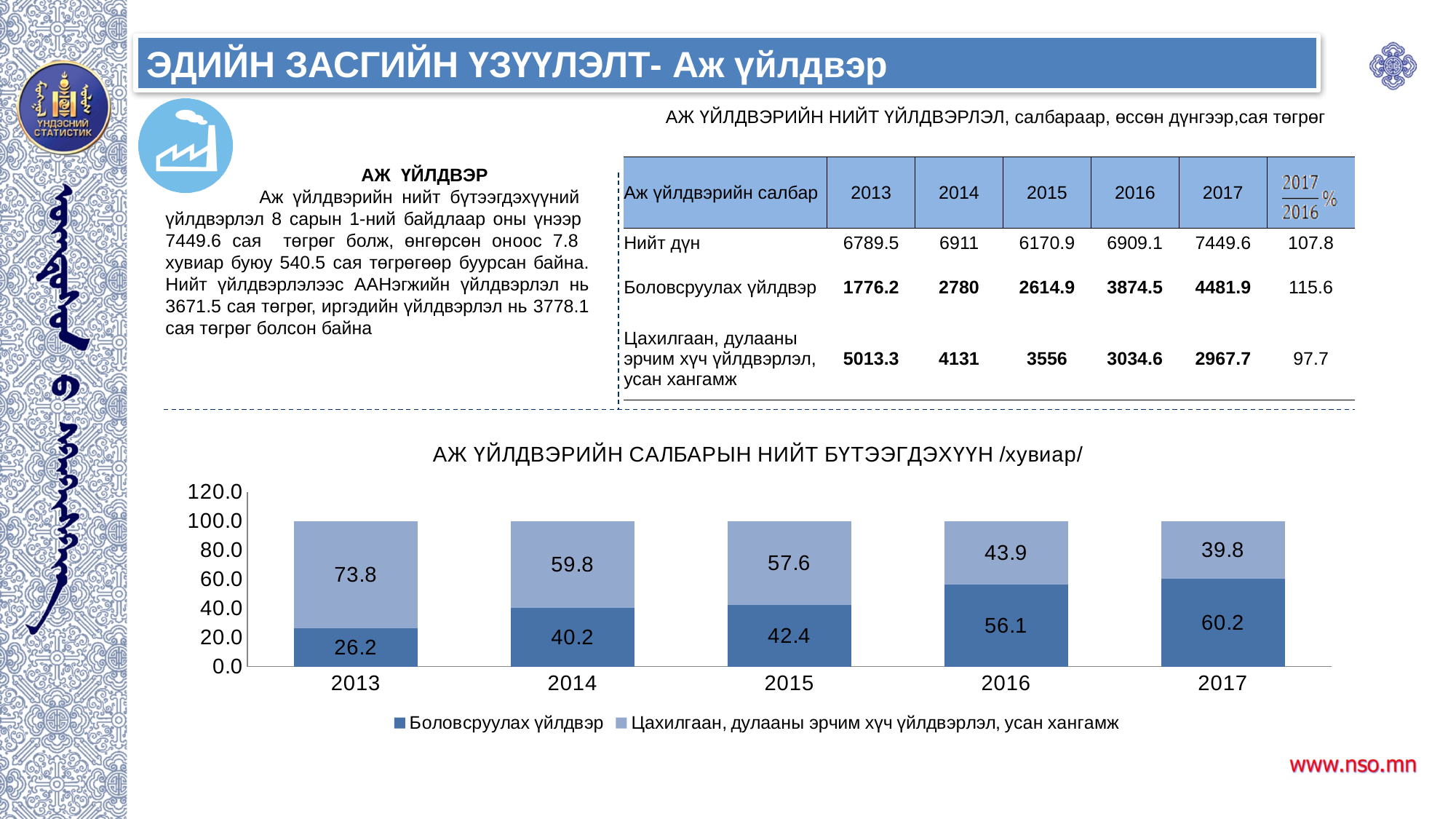
In which year is the value for Цахилгаан, дулааны эрчим хүч үйлдвэрлэл, усан хангамж lowest? 2017 What is the value for Боловсруулах үйлдвэр in 2013? 26.2 Does the value for Боловсруулах үйлдвэр rise or fall from 2013 to 2017? rise How many years are shown on the x axis of the chart? 5 What is the total of the stacked bar for 2014? 100.0 How many series does the chart legend list? 2 In which year is the value for Боловсруулах үйлдвэр highest? 2017 Which is larger in 2015: Боловсруулах үйлдвэр or Цахилгаан, дулааны эрчим хүч үйлдвэрлэл, усан хангамж? Цахилгаан, дулааны эрчим хүч үйлдвэрлэл, усан хангамж What type of chart is shown on the slide? stacked bar chart What is the value for Цахилгаан, дулааны эрчим хүч үйлдвэрлэл, усан хангамж in 2016? 43.9 What is the difference between the Боловсруулах үйлдвэр values for 2017 and 2013? 34.0 What is the value for Боловсруулах үйлдвэр in 2017? 60.2